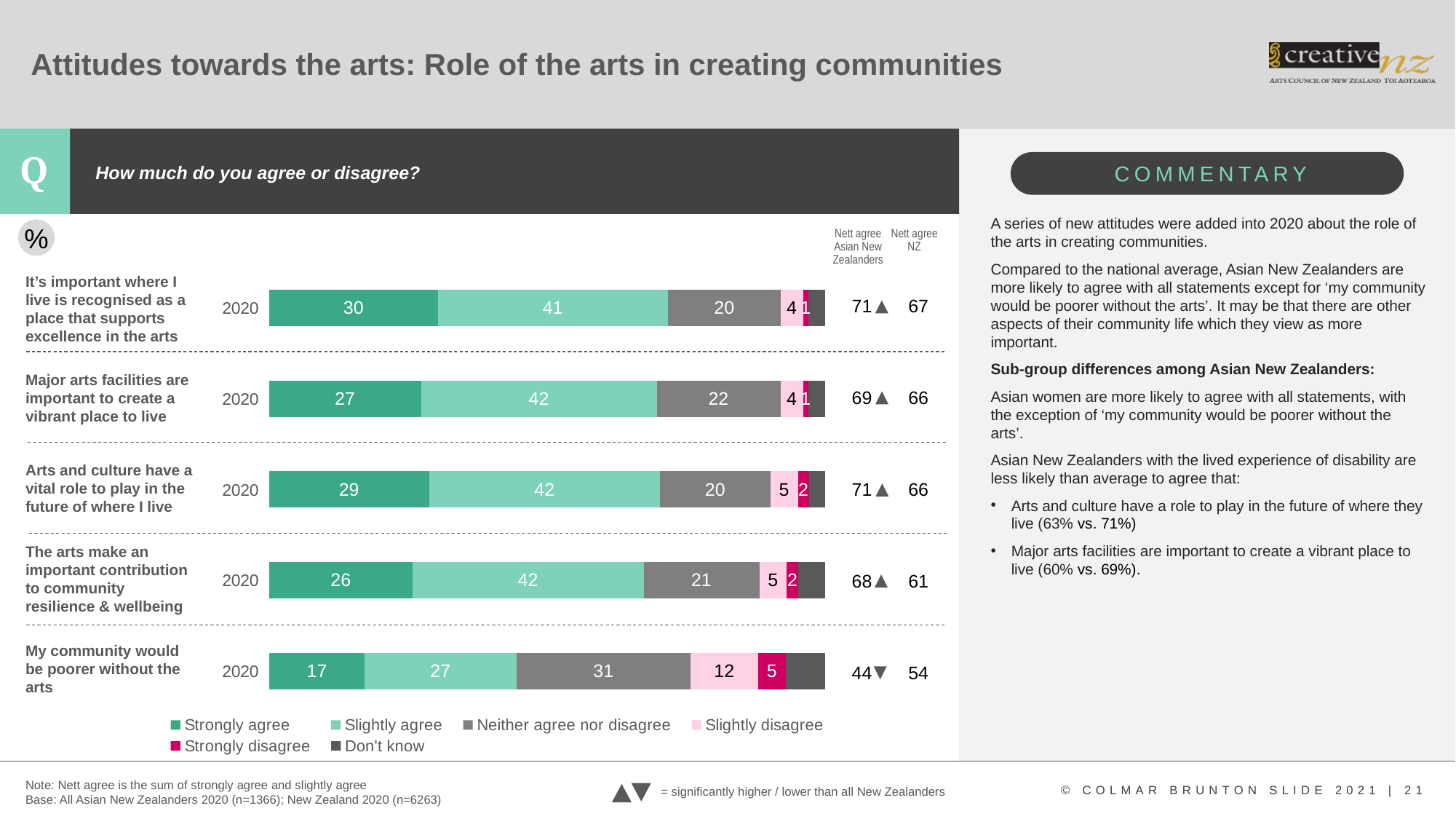
Which statement has the lowest Strongly agree value? My community would be poorer without the arts What is the Neither agree nor disagree value for 'Arts and culture have a vital role to play in the future of where I live'? 20 How many statements are shown in the chart? 5 What is the Strongly agree value for 'My community would be poorer without the arts'? 17 What is the Slightly agree value for 'Major arts facilities are important to create a vibrant place to live'? 42 Which has the larger Strongly disagree value: 'My community would be poorer without the arts' or 'Arts and culture have a vital role to play in the future of where I live'? My community would be poorer without the arts Which statement has the highest Strongly agree value? It's important where I live is recognised as a place that supports excellence in the arts What is the difference between the Neither agree nor disagree values for 'My community would be poorer without the arts' and 'It's important where I live is recognised as a place that supports excellence in the arts'? 11 What is the Nett agree value for Asian New Zealanders for 'The arts make an important contribution to community resilience & wellbeing'? 68 What is the Nett agree NZ value for 'My community would be poorer without the arts'? 54 How many series does the legend list? 6 What kind of chart is shown on the slide? Stacked bar chart